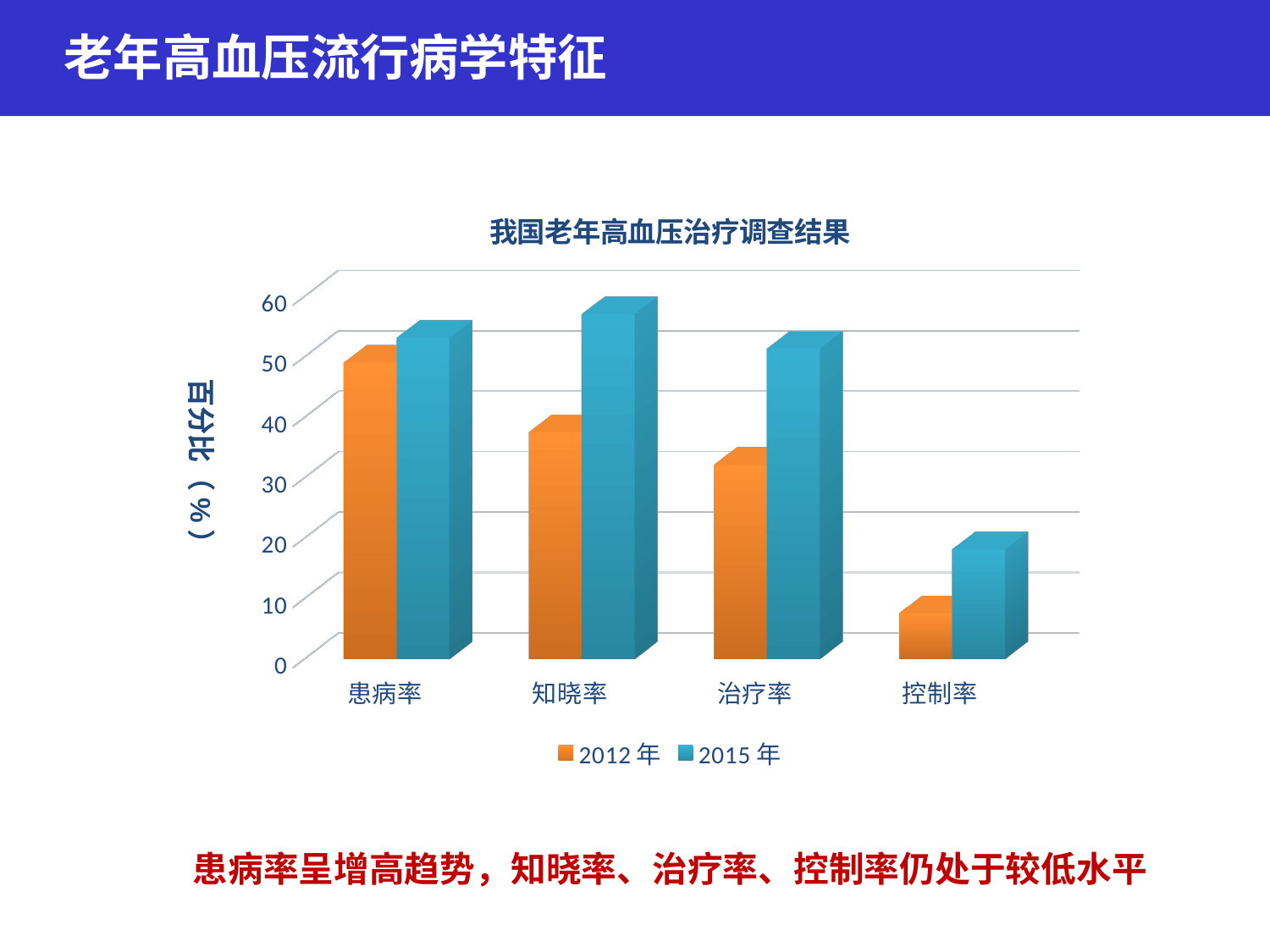
Which category has the highest value for the 2015 年 series? 知晓率 What is the title of the chart? 我国老年高血压治疗调查结果 What kind of chart is shown on the slide? bar chart Is the 2012 年 value for 控制率 greater or less than 20? less Is the 2012 年 value for 患病率 greater or less than 40? greater Which category has the lowest value for the 2012 年 series? 控制率 For 治疗率, which series has the larger value, 2012 年 or 2015 年? 2015 年 How many series does the chart legend list? 2 Which category has the lowest value for the 2015 年 series? 控制率 For the 2012 年 series, which is larger, 患病率 or 知晓率? 患病率 Is the 2015 年 value for 知晓率 greater or less than 50? greater How many categories are shown on the x axis of the chart? 4